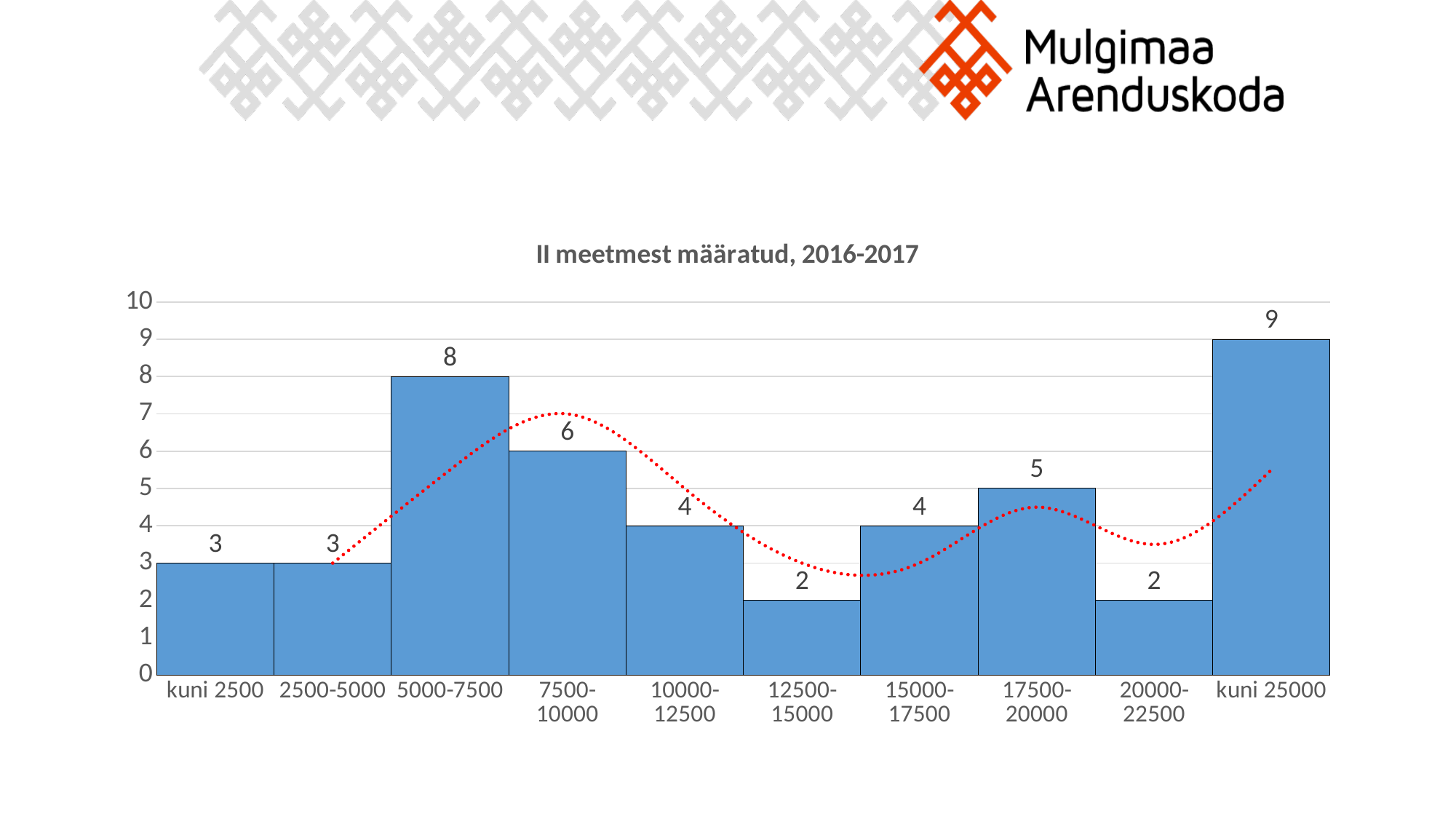
What is the title of the chart? II meetmest määratud, 2016-2017 What is the value for the 12500-15000 category? 2 Is the value for 7500-10000 greater or less than 5? greater Which is larger, the value for 10000-12500 or the value for 17500-20000? 17500-20000 What is the value for the 5000-7500 category? 8 What is the difference between the values for 7500-10000 and 12500-15000? 4 What is the value for the kuni 25000 category? 9 What is the difference between the values for kuni 25000 and 5000-7500? 1 How many categories are shown on the x axis? 10 What is the value for the 17500-20000 category? 5 Which category has the highest value? kuni 25000 What kind of chart is shown on the slide? bar chart